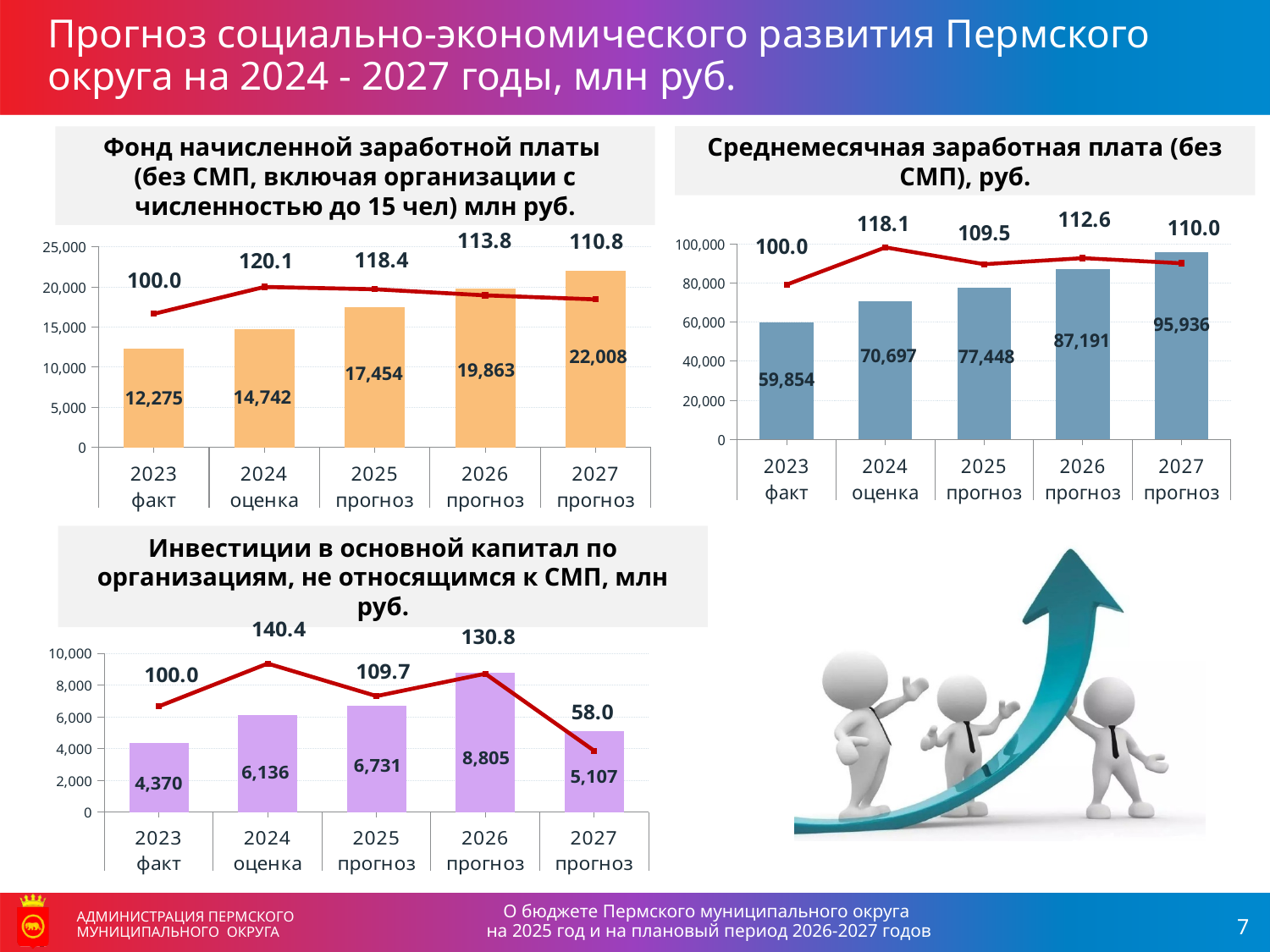
On the chart 'Фонд начисленной заработной платы', what is the bar value for 2025 прогноз? 17,454 On the chart 'Фонд начисленной заработной платы', what is the difference between the bar values for 2027 прогноз and 2023 факт? 9,733 On the chart 'Инвестиции в основной капитал', which is larger: the bar value for 2024 оценка or for 2027 прогноз? 2024 оценка On the chart 'Среднемесячная заработная плата (без СМП), руб.', what is the line value shown above 2025 прогноз? 109.5 On the chart 'Инвестиции в основной капитал', what is the line value shown above 2027 прогноз? 58.0 On the chart 'Среднемесячная заработная плата (без СМП), руб.', which year has the lowest bar value? 2023 факт How many year categories are shown on the x axis of the chart 'Инвестиции в основной капитал'? 5 On the chart 'Инвестиции в основной капитал', what is the bar value for 2026 прогноз? 8,805 On the chart 'Фонд начисленной заработной платы', which year has the highest bar value? 2027 прогноз On the chart 'Среднемесячная заработная плата (без СМП), руб.', what is the bar value for 2026 прогноз? 87,191 On the chart 'Среднемесячная заработная плата (без СМП), руб.', do the bar values rise or fall from 2023 to 2027? rise On the chart 'Фонд начисленной заработной платы', what is the line value shown above 2024 оценка? 120.1